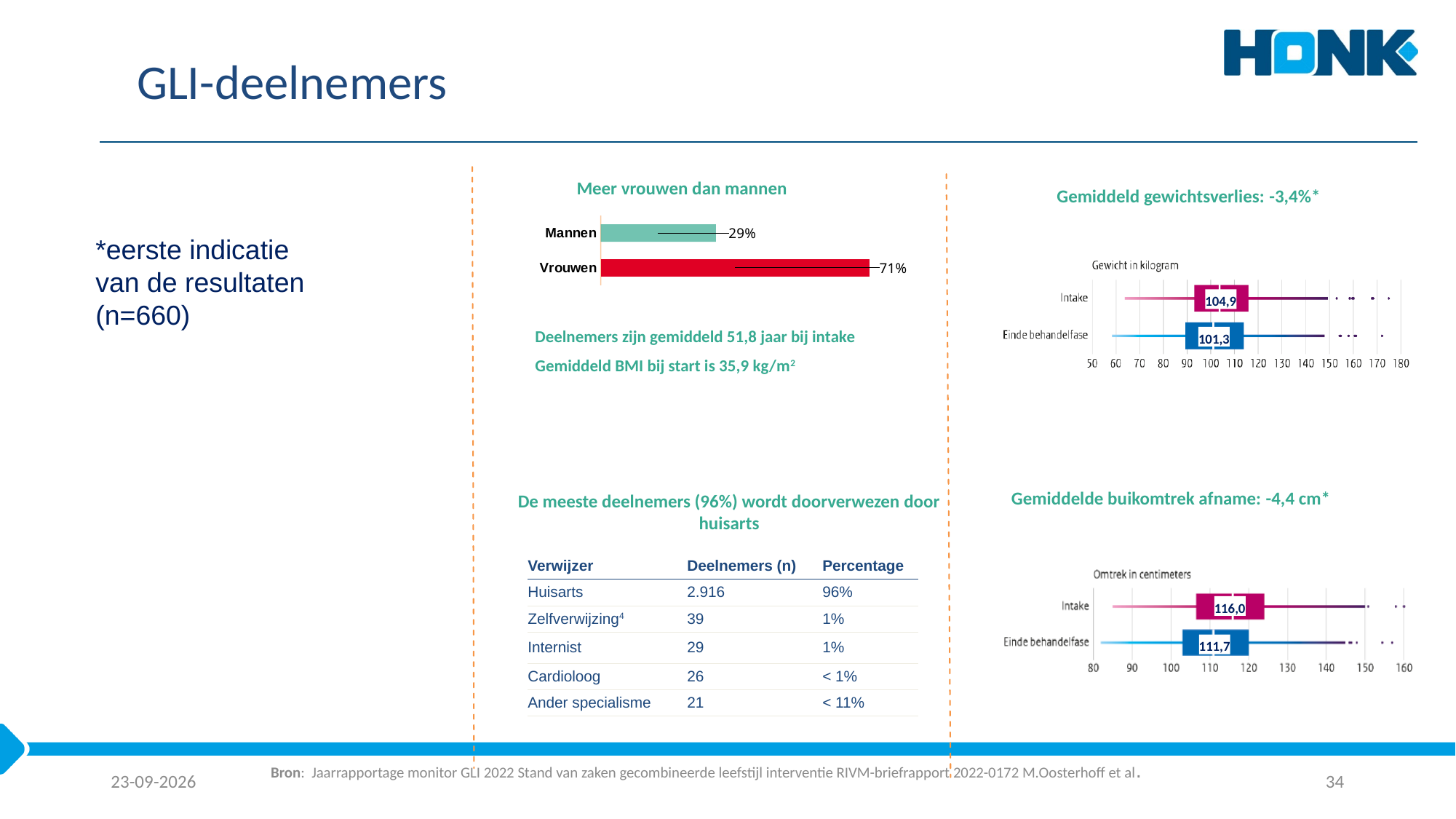
In the 'Gewicht in kilogram' chart under 'Gemiddeld gewichtsverlies', what value is labelled for Intake? 104,9 In the 'Meer vrouwen dan mannen' chart, what is the value for Mannen? 29% In the 'Meer vrouwen dan mannen' chart, what colour is the Vrouwen bar? Red In the 'Meer vrouwen dan mannen' chart, which category has the lowest value? Mannen In the 'Meer vrouwen dan mannen' chart, what is the value for Vrouwen? 71% In the 'Omtrek in centimeters' chart under 'Gemiddelde buikomtrek afname', what value is labelled for Intake? 116,0 In the 'Meer vrouwen dan mannen' chart, what is the difference between the values for Vrouwen and Mannen? 42% In the 'Gewicht in kilogram' chart under 'Gemiddeld gewichtsverlies', what value is labelled for Einde behandelfase? 101,3 In the 'Meer vrouwen dan mannen' chart, which category has the highest value? Vrouwen In the 'Omtrek in centimeters' chart under 'Gemiddelde buikomtrek afname', what is the difference between the labelled values for Intake and Einde behandelfase? 4,3 What kind of chart is the 'Meer vrouwen dan mannen' chart? Bar chart In the 'Meer vrouwen dan mannen' chart, how many categories are shown? 2